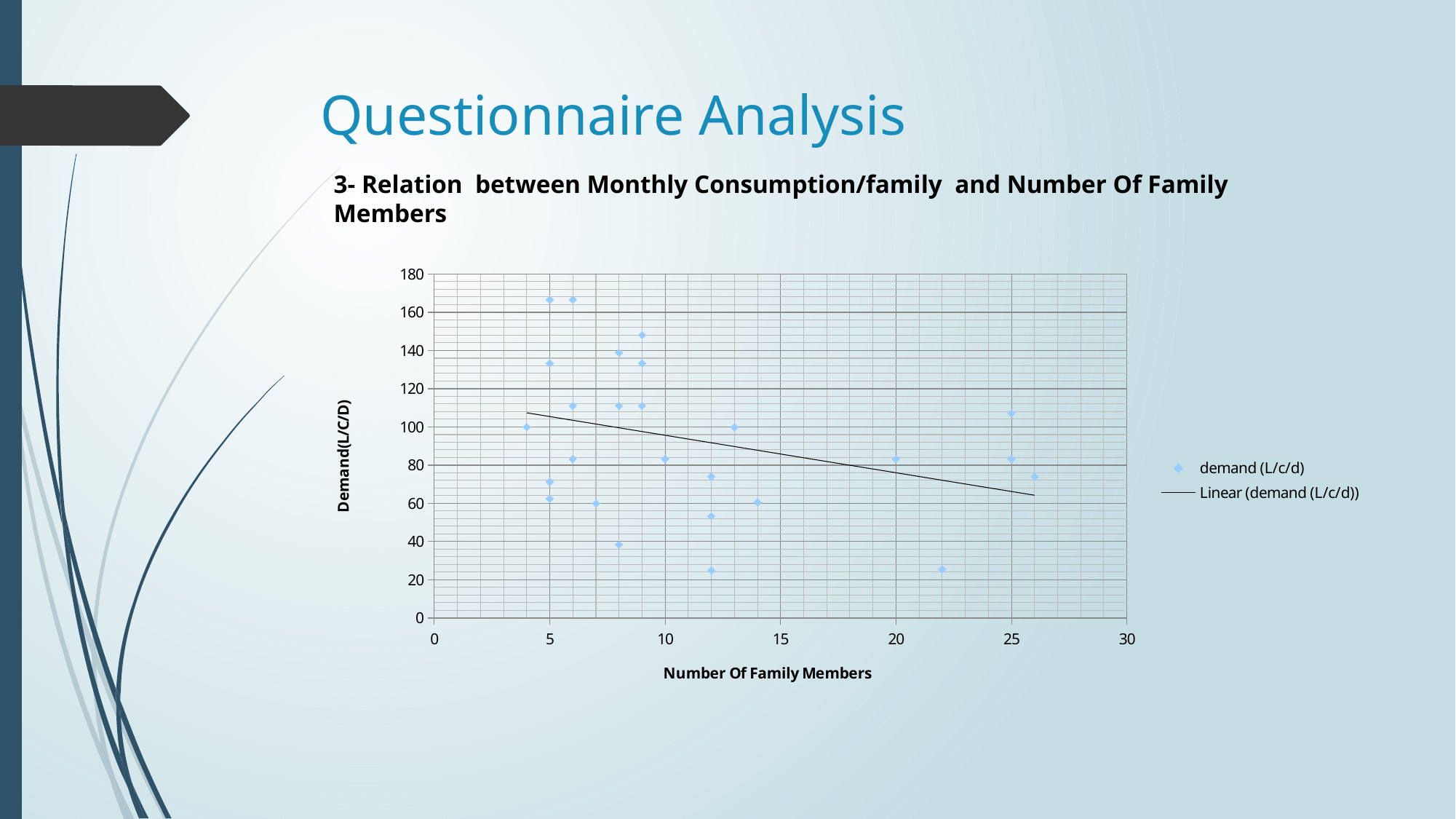
Which has the higher demand value: the point at 20 family members or the point at 22 family members? 20 family members Is the highest demand value plotted at 9 family members greater or less than 140? greater What is the title of the horizontal axis of the chart? Number Of Family Members Is the highest demand value plotted at 5 family members greater or less than 160? greater What is the title of the vertical axis of the chart? Demand(L/C/D) Is the highest demand value plotted at 9 family members greater or less than 160? less What kind of chart is shown on the slide? scatter chart How many entries does the chart legend list? 2 Does the linear trendline rise or fall as the number of family members increases? fall